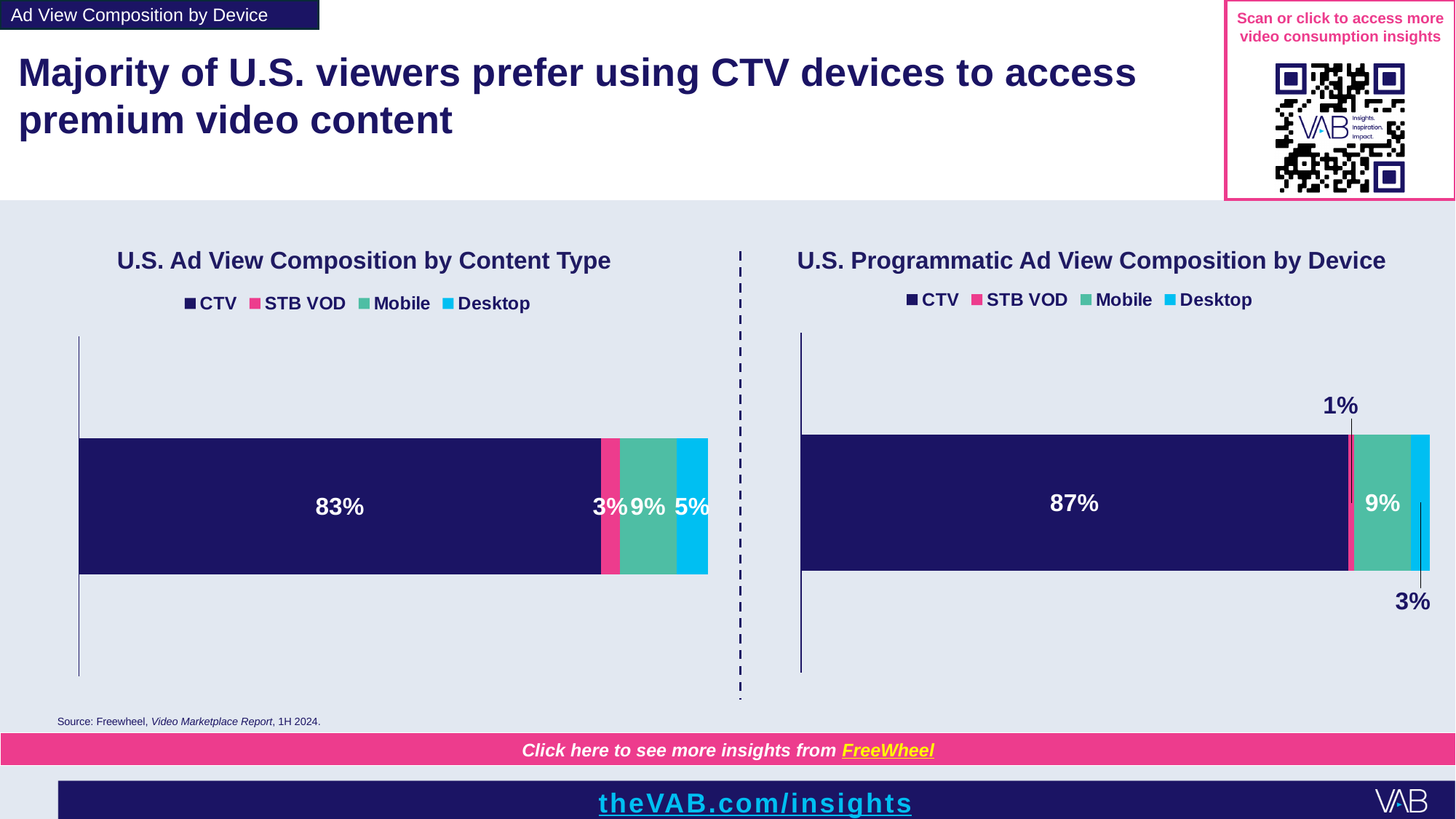
In the 'U.S. Programmatic Ad View Composition by Device' chart, which series has the largest share? CTV In the 'U.S. Ad View Composition by Content Type' chart, what is the difference between the CTV and Mobile values? 74 percentage points In the 'U.S. Programmatic Ad View Composition by Device' chart, what is the total of the stacked bar? 100% In the 'U.S. Programmatic Ad View Composition by Device' chart, what is the value for CTV? 87% In the 'U.S. Ad View Composition by Content Type' chart, which is larger, Desktop or STB VOD? Desktop In the 'U.S. Ad View Composition by Content Type' chart, what is the value for Mobile? 9% What kind of chart is the 'U.S. Ad View Composition by Content Type' chart? Stacked bar chart In the 'U.S. Ad View Composition by Content Type' chart, which series has the smallest share? STB VOD In the 'U.S. Programmatic Ad View Composition by Device' chart, what is the value for Desktop? 3% In the 'U.S. Programmatic Ad View Composition by Device' chart, what is the value for STB VOD? 1% How many series does the legend of the 'U.S. Programmatic Ad View Composition by Device' chart list? 4 In the 'U.S. Ad View Composition by Content Type' chart, what is the value for CTV? 83%